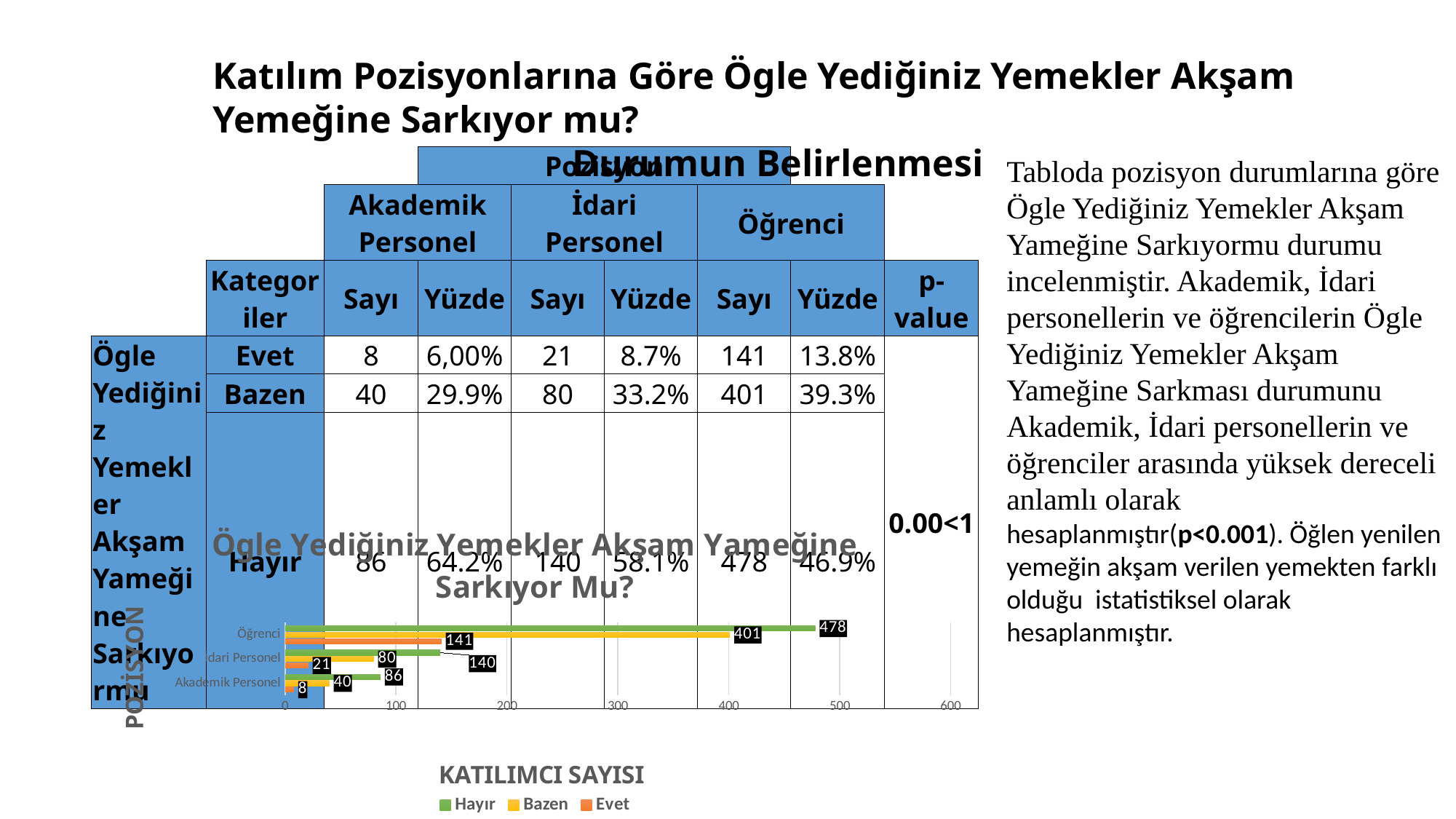
What is the Evet value for Akademik Personel in the chart? 8 What is the difference between the Hayır value for Öğrenci and the Hayır value for İdari Personel? 338 Which category has the lowest Bazen value in the chart? Akademik Personel Which category has the highest Hayır value in the chart? Öğrenci Is the Hayır value for Öğrenci greater or less than 400? greater What is the Hayır value for Öğrenci in the chart? 478 How many position categories are plotted on the chart? 3 What is the Bazen value for İdari Personel in the chart? 80 How many series does the chart legend list? 3 What kind of chart is shown on the slide? bar chart What is the title of the chart's horizontal axis? KATILIMCI SAYISI Which is larger in the chart: the Bazen value for Öğrenci or the Evet value for Öğrenci? Bazen value for Öğrenci